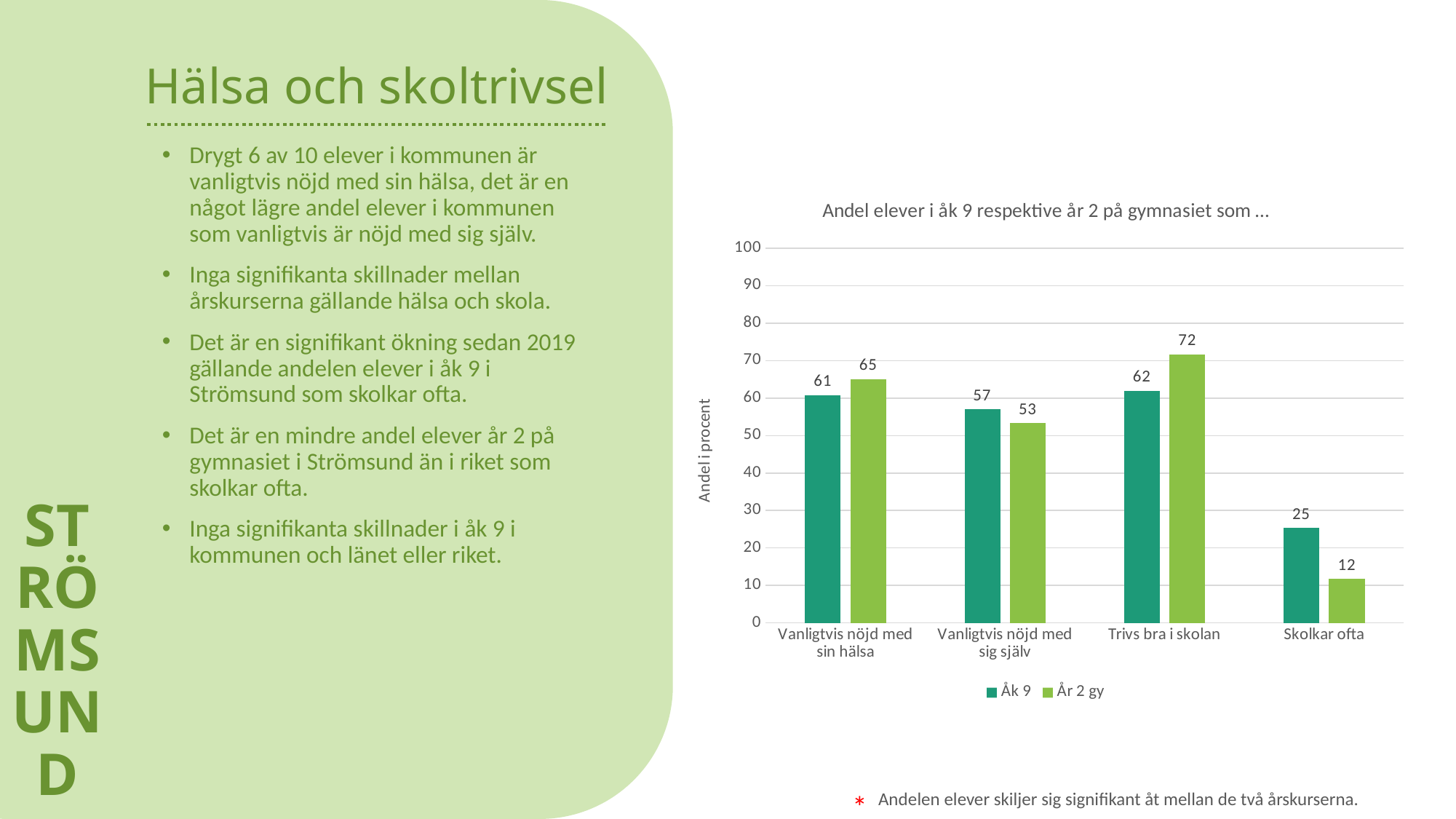
What is the label of the y axis? Andel i procent Is the value for Åk 9 in 'Vanligtvis nöjd med sin hälsa' greater or less than 50? greater What is the value for Åk 9 in the category 'Trivs bra i skolan'? 62 What is the difference between the Åk 9 and År 2 gy values for 'Skolkar ofta'? 13 What kind of chart is shown on the slide? Bar chart Which category has the highest value for År 2 gy? Trivs bra i skolan Which is larger for 'Vanligtvis nöjd med sig själv': Åk 9 or År 2 gy? Åk 9 How many categories are shown on the x axis? 4 How many series does the legend list? 2 Which category has the lowest value for Åk 9? Skolkar ofta What is the value for År 2 gy in the category 'Vanligtvis nöjd med sin hälsa'? 65 What is the value for År 2 gy in the category 'Skolkar ofta'? 12